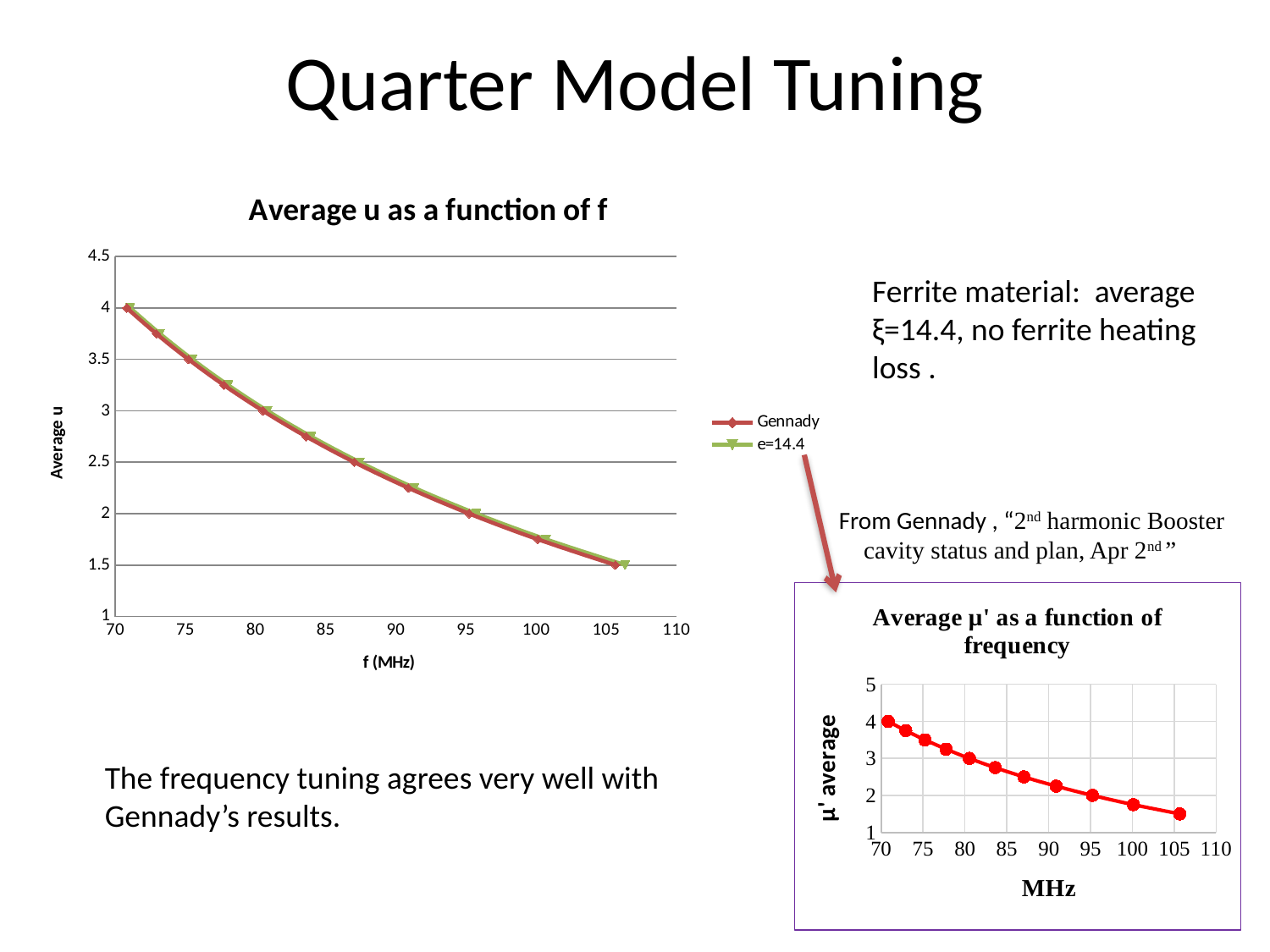
In the 'Average μ' as a function of frequency' chart, is the value near 80 MHz greater or less than 2? greater In the 'Average μ' as a function of frequency' chart, is the value near 105 MHz greater or less than 2? less In the 'Average u as a function of f' chart, is the Gennady value near 75 MHz greater or less than 3? greater In the 'Average μ' as a function of frequency' chart, do the values rise or fall as MHz increases? fall What kind of chart is the 'Average u as a function of f' chart? line chart What kind of chart is the 'Average μ' as a function of frequency' chart? line chart What are the two legend entries in the 'Average u as a function of f' chart? Gennady and e=14.4 What is the x-axis title of the 'Average u as a function of f' chart? f (MHz) How many series does the legend of the 'Average u as a function of f' chart list? 2 How many data points are plotted in the 'Average μ' as a function of frequency' chart? 11 In the 'Average u as a function of f' chart, do the values rise or fall as f increases? fall